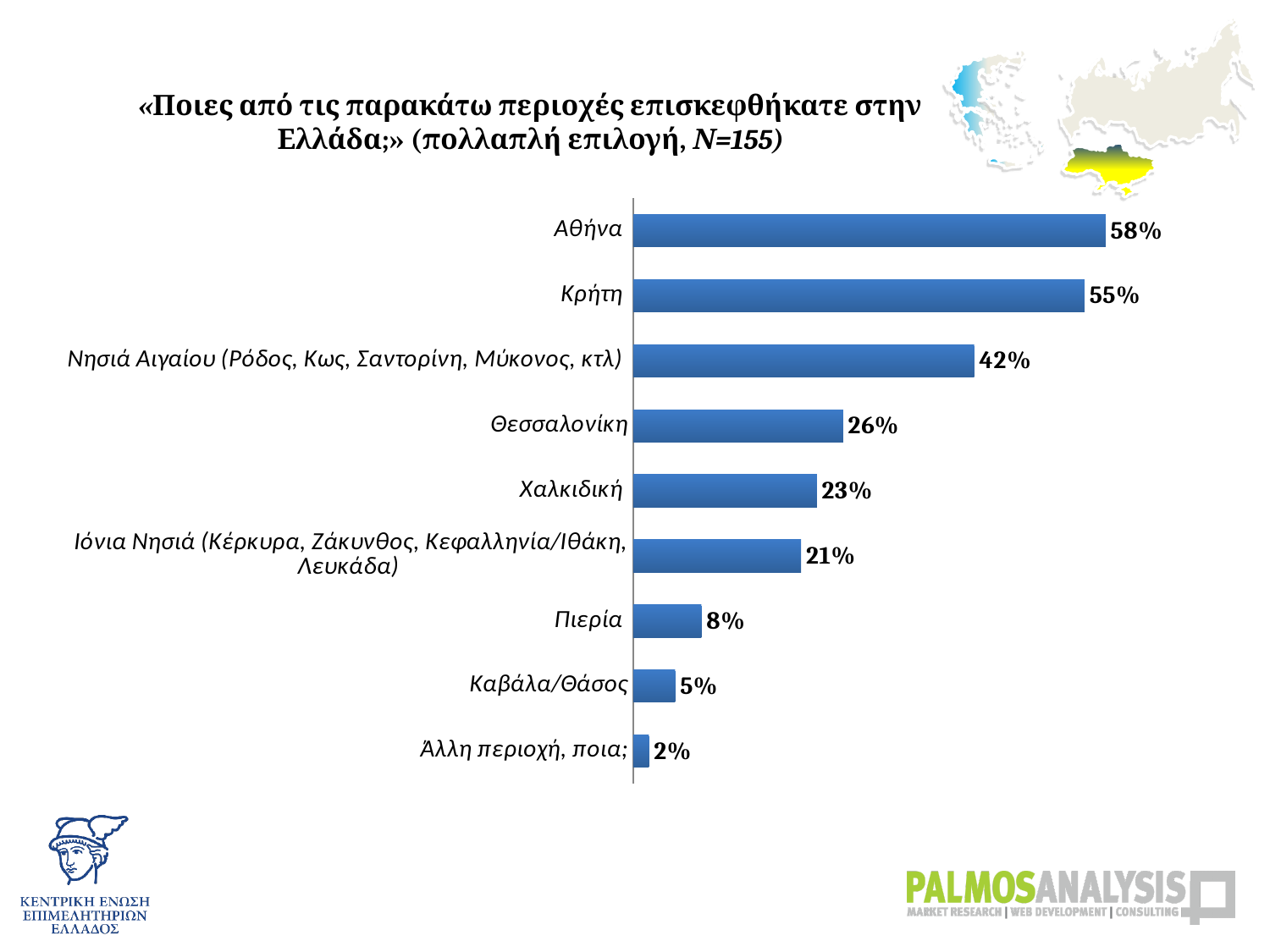
What is the value for Θεσσαλονίκη? 26% What kind of chart is shown on the slide? Bar chart Which category has the lowest value? Άλλη περιοχή, ποια; What is the sample size (N) stated in the chart title? N=155 Which is larger, the value for Νησιά Αιγαίου or the value for Ιόνια Νησιά? Νησιά Αιγαίου Which region has the highest value? Αθήνα How many categories are shown in the chart? 9 What is the value for Ιόνια Νησιά (Κέρκυρα, Ζάκυνθος, Κεφαλληνία/Ιθάκη, Λευκάδα)? 21% What is the value for Αθήνα? 58% What is the value for Καβάλα/Θάσος? 5% What is the difference between the values for Πιερία and Καβάλα/Θάσος? 3% What is the difference between the values for Κρήτη and Χαλκιδική? 32%